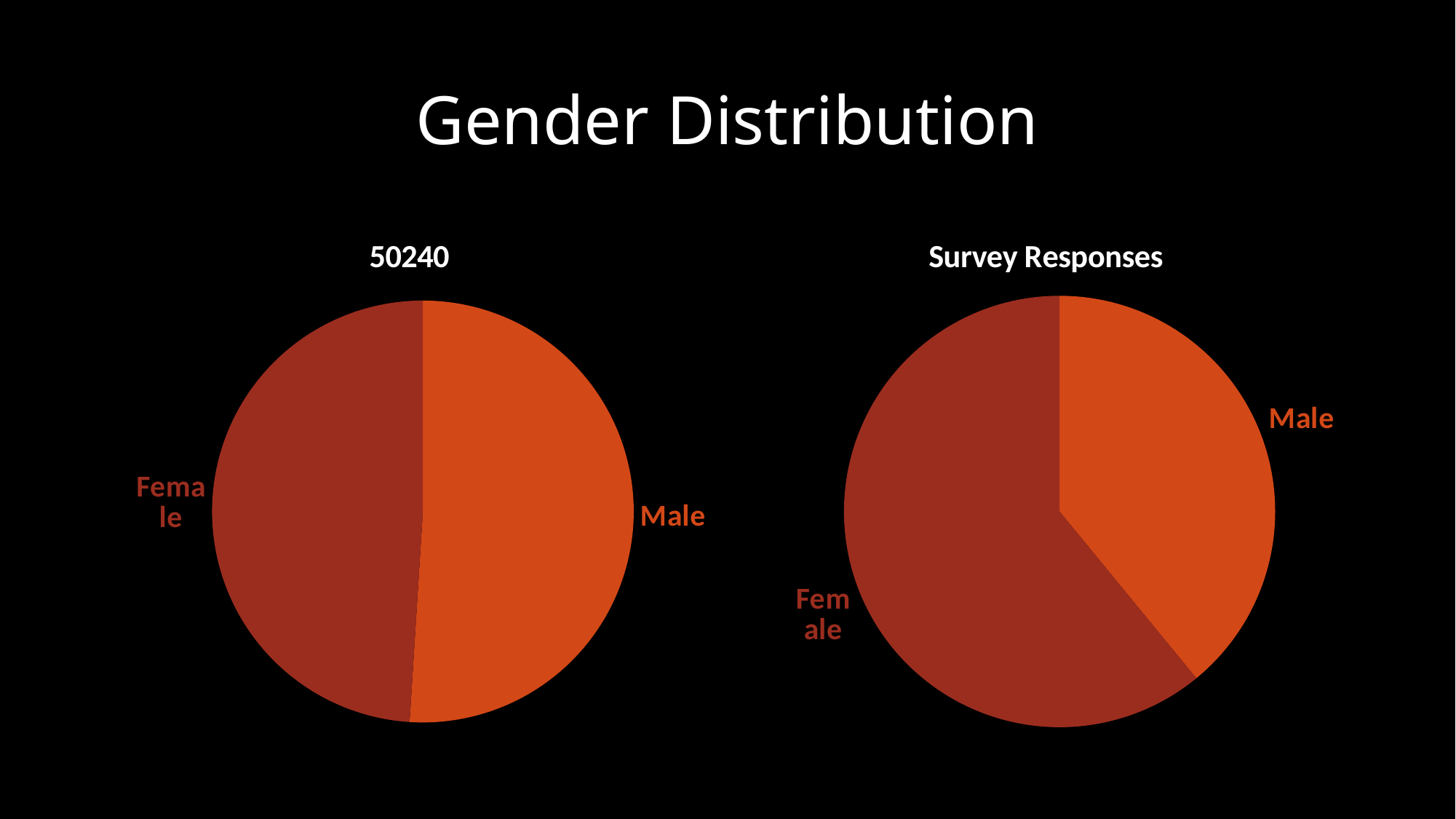
What is the title of the pie chart on the right of the slide? Survey Responses In the chart titled "Survey Responses", which category has the largest slice? Female How many pie charts are shown on the slide? 2 In the chart titled "Survey Responses", how many slices does the pie have? 2 What is the title of the pie chart on the left of the slide? 50240 What kind of chart is the chart titled "50240"? pie chart In the chart titled "50240", how many categories are shown? 2 In the chart titled "Survey Responses", which category has the smallest slice? Male What kind of chart is the chart titled "Survey Responses"? pie chart In the chart titled "Survey Responses", which slice is larger, Male or Female? Female